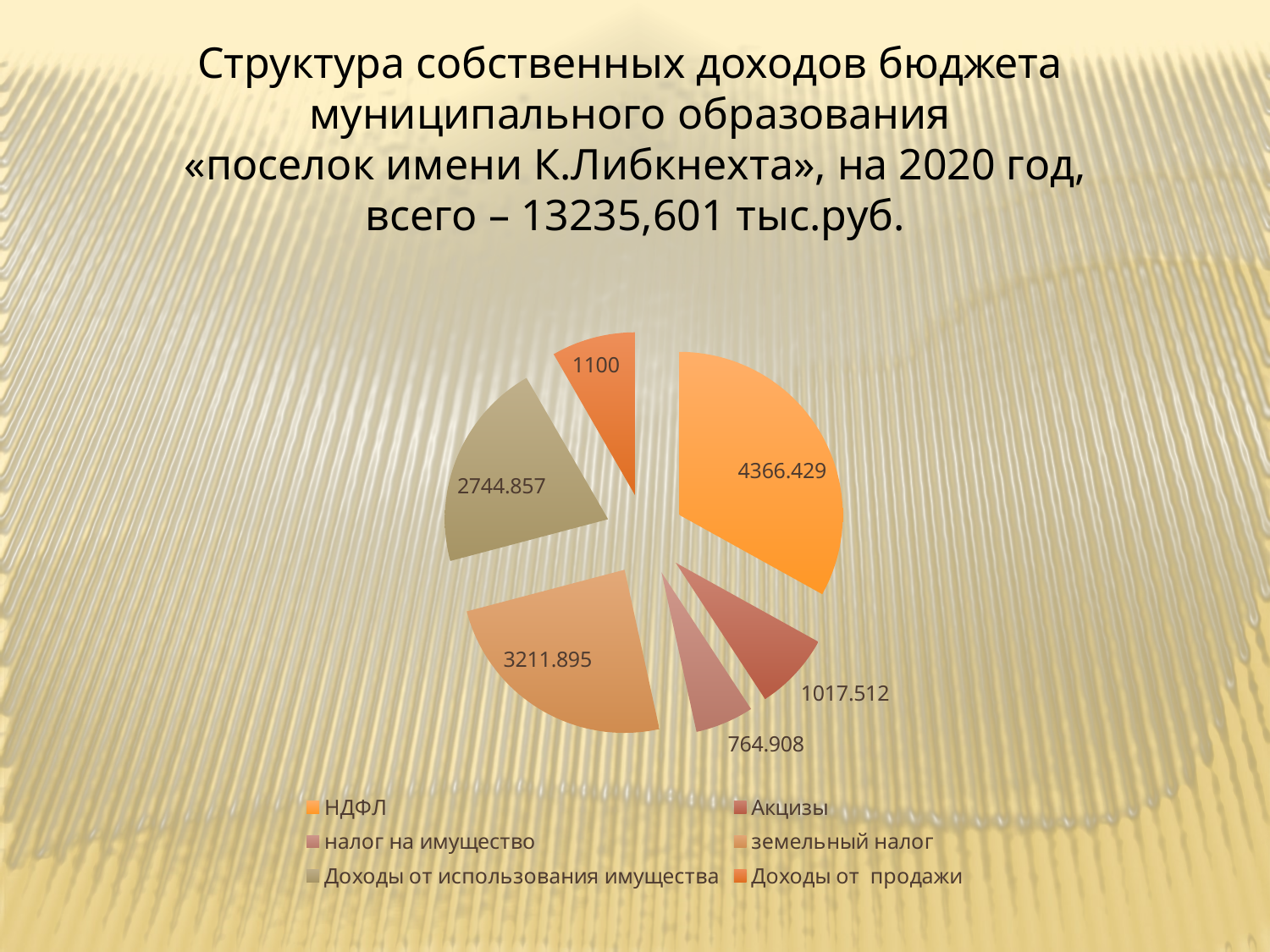
What is the value for Акцизы? 1017.512 How many slices does the pie chart have? 6 What is the value for Доходы от использования имущества? 2744.857 Which category has the largest slice of the pie? НДФЛ What is the value for земельный налог? 3211.895 What is the difference between the values for НДФЛ and земельный налог? 1154.534 What is the value for НДФЛ? 4366.429 Which category has the smallest slice of the pie? налог на имущество What total amount in тыс.руб. is stated in the chart title? 13235,601 тыс.руб. What is the value for Доходы от продажи? 1100 Which is larger, the value for Акцизы or the value for Доходы от продажи? Доходы от продажи What type of chart is shown on the slide? pie chart